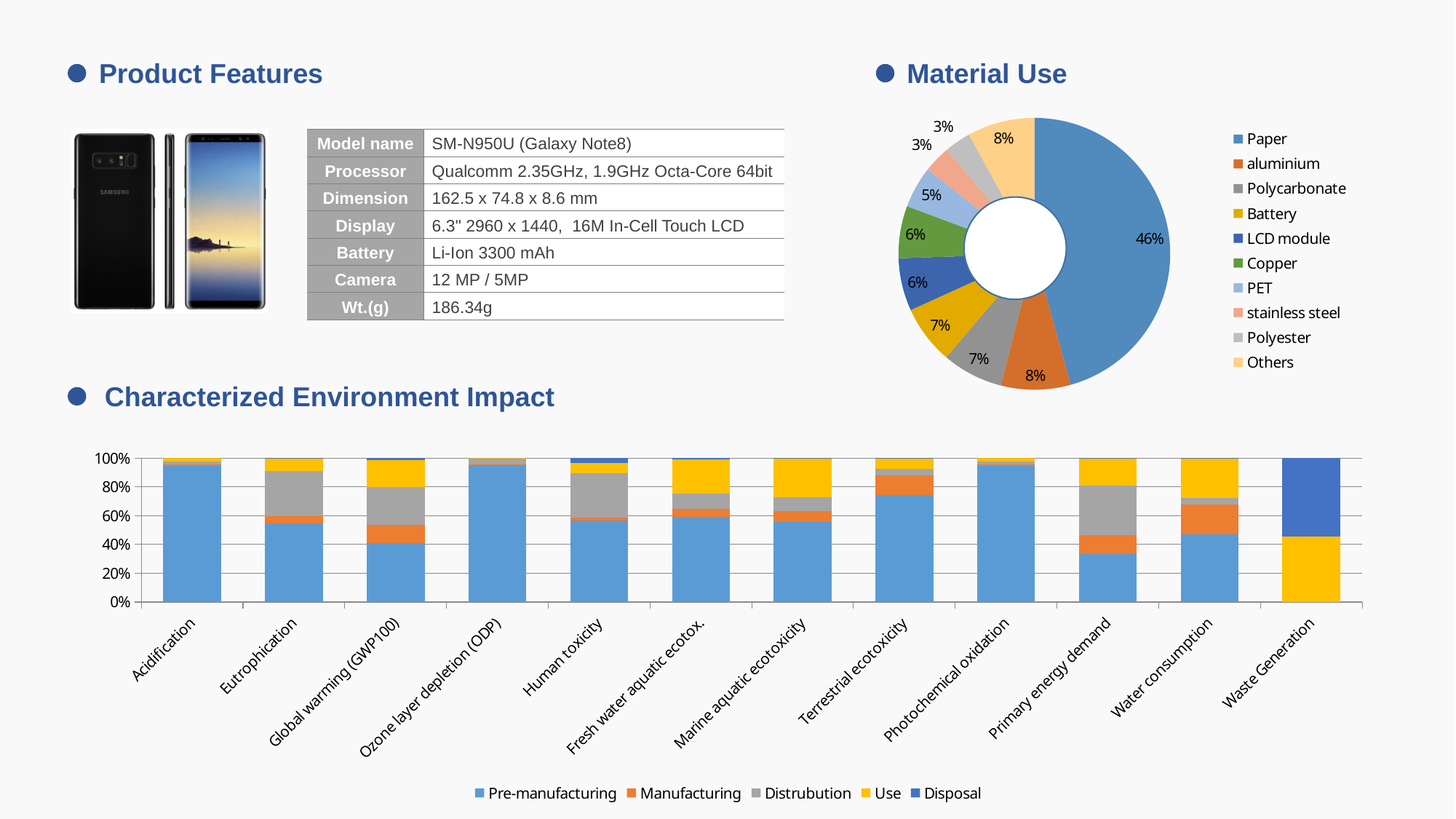
How many series does the legend of the Characterized Environment Impact chart list? 5 In the Material Use pie chart, which material has the largest share? Paper In the Characterized Environment Impact chart, is the Pre-manufacturing share for Acidification greater or less than 80%? greater In the Material Use pie chart, what share does Paper account for? 46% In the Material Use pie chart, what percentage is shown for Copper? 6% In the Material Use pie chart, which is larger, the share for PET or the share for Polycarbonate? Polycarbonate What kind of chart is the Characterized Environment Impact chart? Stacked bar chart In the Material Use pie chart, what is the difference in percentage points between Paper and aluminium? 38 What kind of chart is used for Material Use? Pie chart How many entries does the legend of the Material Use pie chart list? 10 In the Characterized Environment Impact chart, is the Pre-manufacturing share for Primary energy demand greater or less than 40%? less How many impact categories are shown on the x axis of the Characterized Environment Impact chart? 12